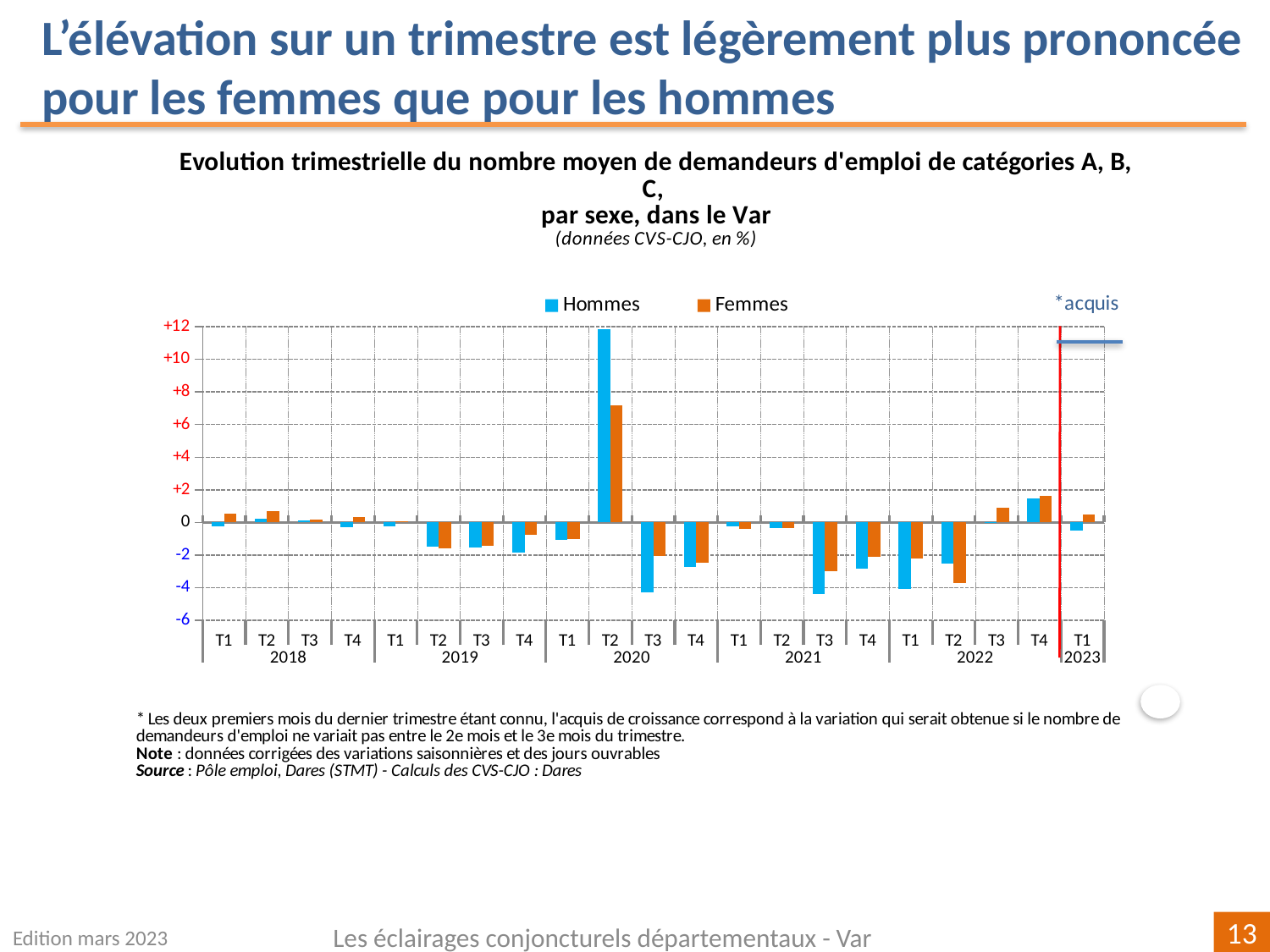
Is the value for Femmes in T2 2022 greater or less than -2? less How many series does the legend list? 2 In which quarter is the value for Hommes highest? T2 2020 What kind of chart is shown on the slide? bar chart Is the value for Femmes in T2 2020 greater or less than +6? greater Is the value for Hommes in T2 2020 greater or less than +10? greater In which quarter is the value for Femmes lowest? T2 2022 In T2 2020, which series has the larger value, Hommes or Femmes? Hommes In which quarter is the value for Femmes highest? T2 2020 Which colour represents the Femmes series in the legend? orange In T1 2023, which series has the larger value, Hommes or Femmes? Femmes How many quarters are plotted along the x axis? 21